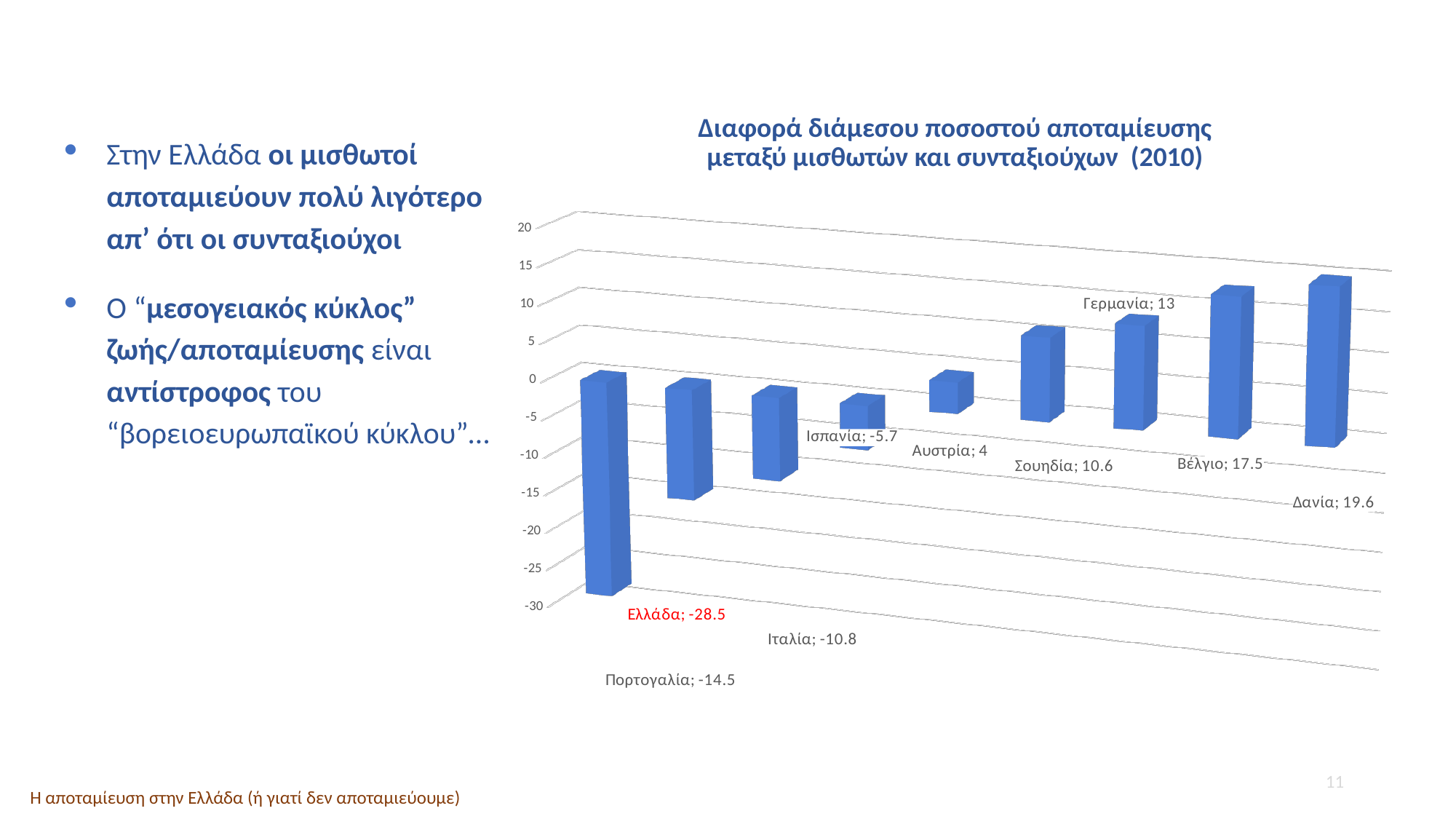
What is the difference between the values for Δανία and Βέλγιο? 2.1 What is the value for Ισπανία? -5.7 How many countries are shown in the chart? 9 Which has a larger value, Γερμανία or Σουηδία? Γερμανία Which country has the highest value? Δανία Is the value for Ιταλία greater or less than -5? less What kind of chart is shown on the slide? bar chart What is the difference between the values for Ελλάδα and Πορτογαλία? 14 Which country has the lowest value? Ελλάδα What is the value for Ελλάδα? -28.5 Do the values rise or fall from left to right along the x axis? rise What is the value for Σουηδία? 10.6